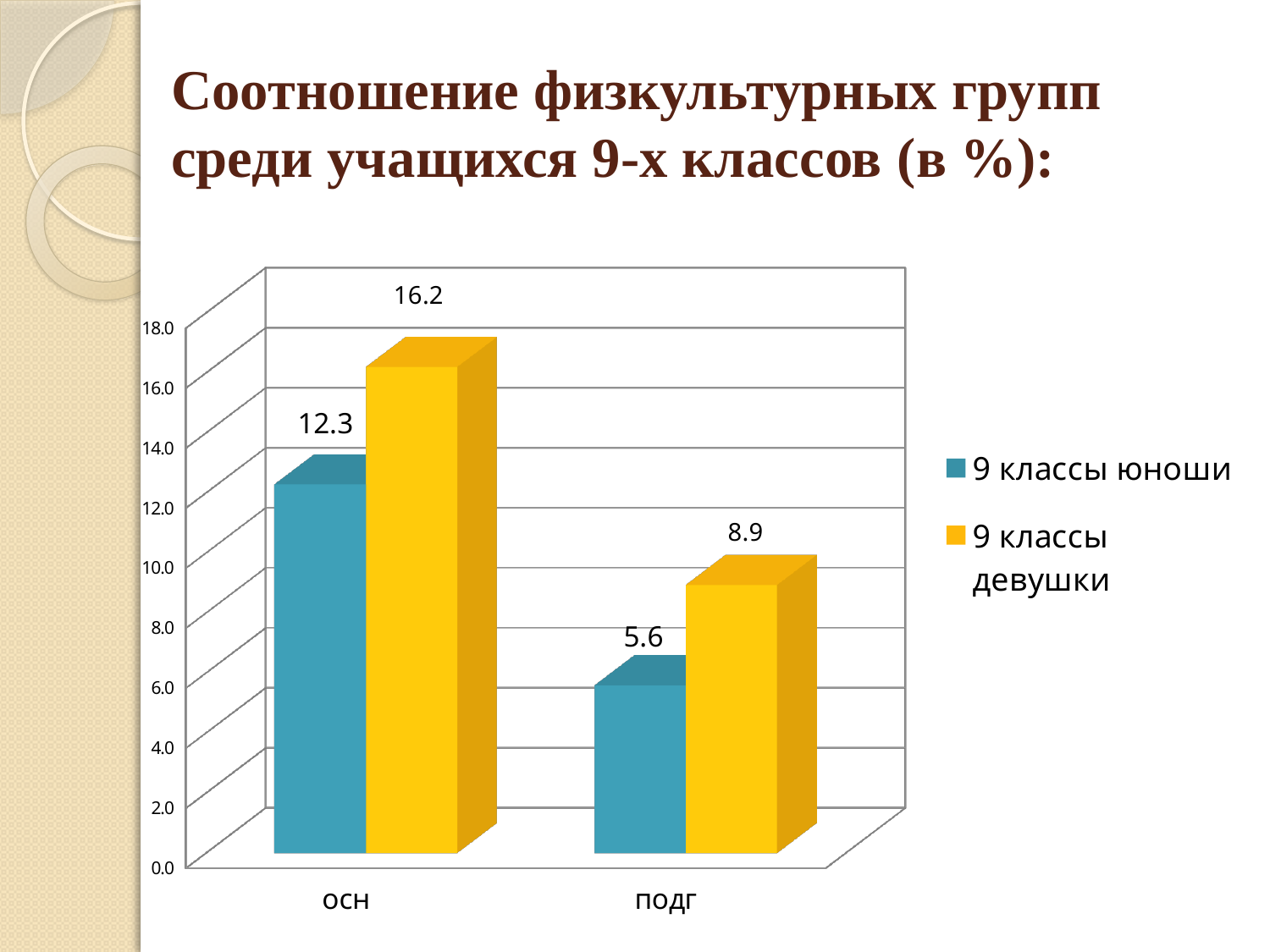
What is the value for '9 классы юноши' in the 'осн' category? 12.3 How many series does the legend list? 2 What kind of chart is shown on the slide? bar chart How many categories are shown on the x axis? 2 What is the difference between '9 классы девушки' and '9 классы юноши' in the 'осн' category? 3.9 What is the value for '9 классы девушки' in the 'осн' category? 16.2 What is the value for '9 классы юноши' in the 'подг' category? 5.6 What is the value for '9 классы девушки' in the 'подг' category? 8.9 Which is larger in the 'подг' category: '9 классы юноши' or '9 классы девушки'? 9 классы девушки What is the difference between the '9 классы юноши' values for 'осн' and 'подг'? 6.7 Which category has the highest value for '9 классы девушки'? осн Which category has the lowest value for '9 классы юноши'? подг